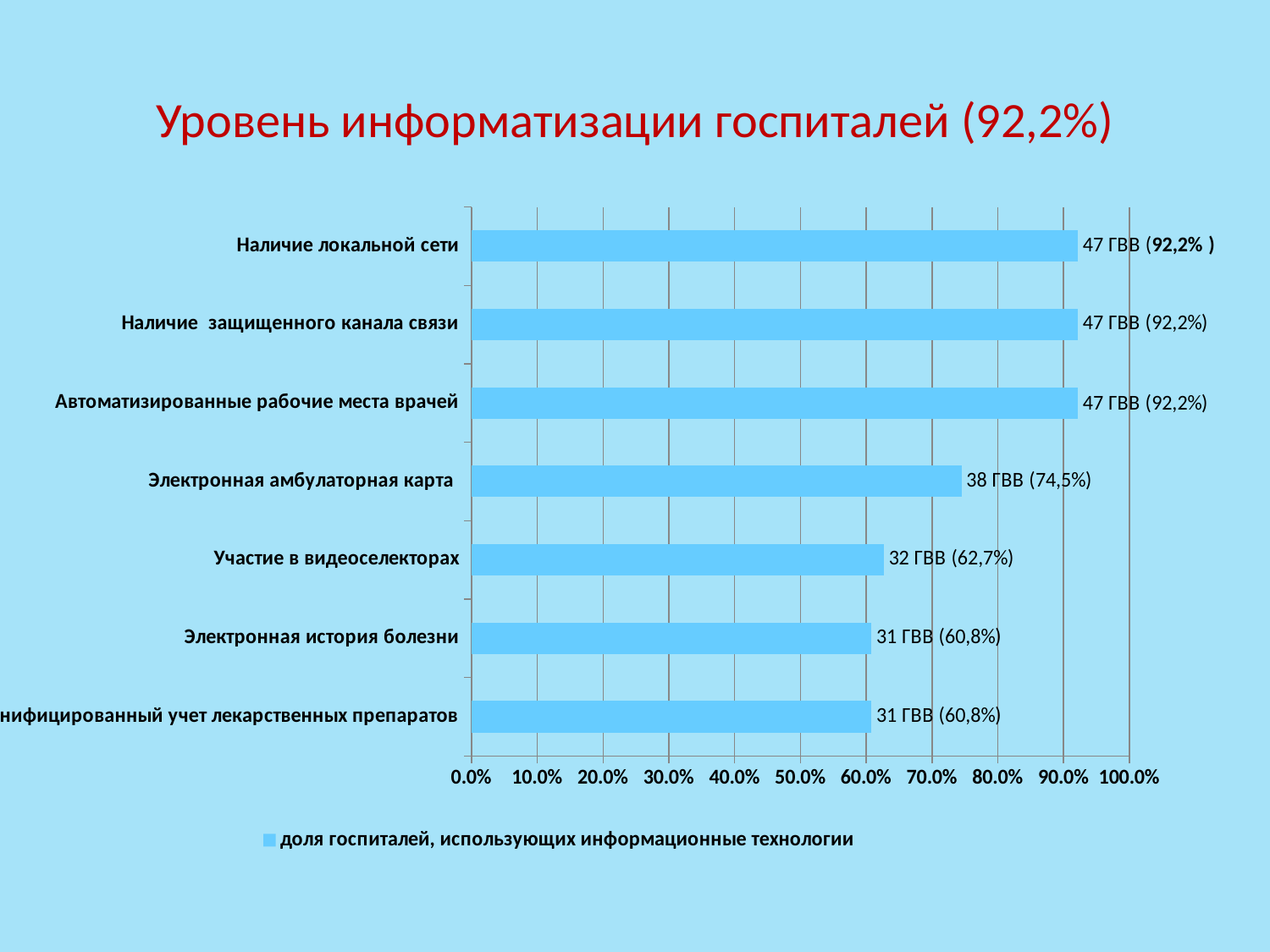
What is the difference in percentage points between 'Электронная амбулаторная карта' (74,5%) and 'Электронная история болезни' (60,8%)? 13,7 How many series does the legend list? 1 Which category has the lowest value, 'Электронная амбулаторная карта' or 'Участие в видеоселекторах'? Участие в видеоселекторах What is the data label for 'Участие в видеоселекторах'? 32 ГВВ (62,7%) What is the legend entry of the chart? доля госпиталей, использующих информационные технологии How many categories are plotted in the chart? 7 What is the data label for 'Электронная амбулаторная карта'? 38 ГВВ (74,5%) How many ГВВ are shown for 'Наличие защищенного канала связи'? 47 ГВВ Is the value for 'Автоматизированные рабочие места врачей' greater or less than 90.0%? greater Is the value for 'Участие в видеоселекторах' greater or less than 70.0%? less What kind of chart is shown on the slide? bar chart What percentage is shown for 'Электронная история болезни'? 60,8%